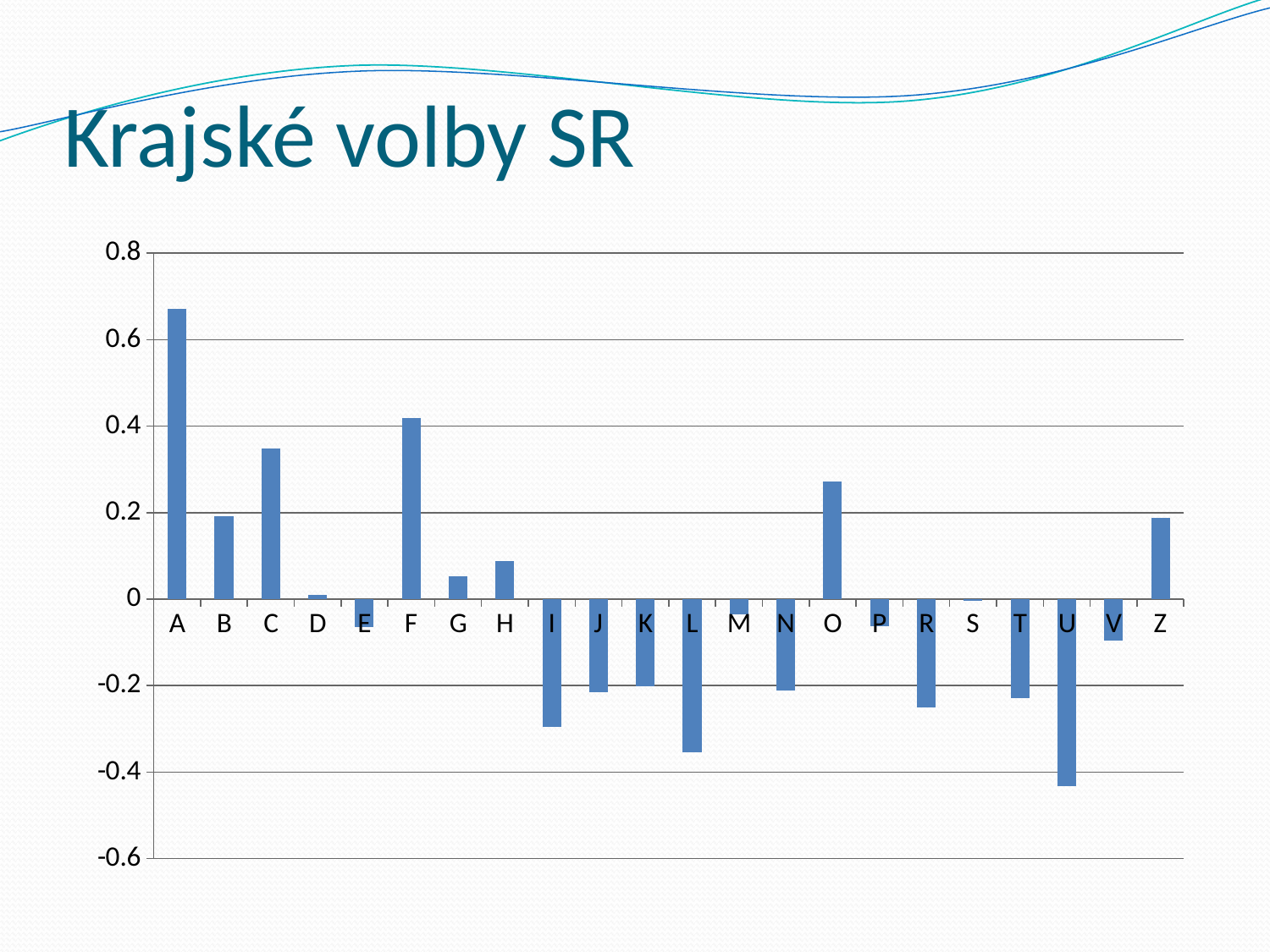
Is the value for U greater or less than -0.4? less Is the value for L greater or less than -0.2? less Is the value for A greater or less than 0.6? greater How many categories are plotted on the x axis of the chart? 22 What is the title of the slide containing the chart? Krajské volby SR What kind of chart is shown on the slide? bar chart Which category has the highest value in the chart? A Which has the larger value, O or Z? O Which has the larger value, C or B? C Which category has the lowest value in the chart? U